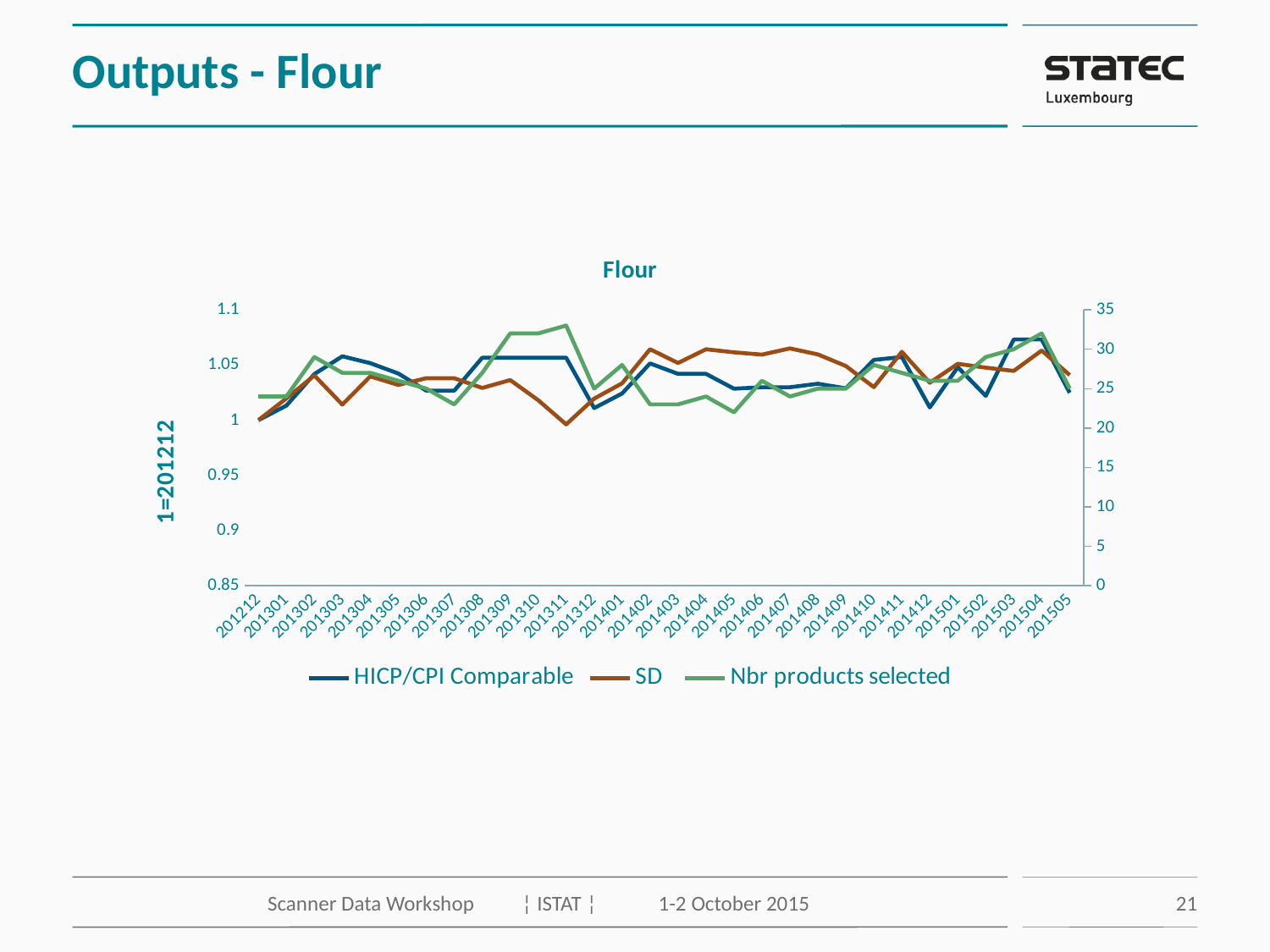
Is the SD value at 201303 greater or less than 1.05? less Is the value of Nbr products selected at 201311 greater or less than 30 on the right axis? greater What kind of chart is shown on the slide? line chart What is the title of the chart? Flour Does the Nbr products selected line rise or fall from 201311 to 201312? fall How many series does the legend of the Flour chart list? 3 What is the label on the left vertical axis of the chart? 1=201212 How many time points are plotted along the x axis of the Flour chart? 30 At 201311, which is larger: HICP/CPI Comparable or SD? HICP/CPI Comparable Is the value of Nbr products selected at 201405 greater or less than 25 on the right axis? less Does the HICP/CPI Comparable line rise or fall from 201212 to 201302? rise